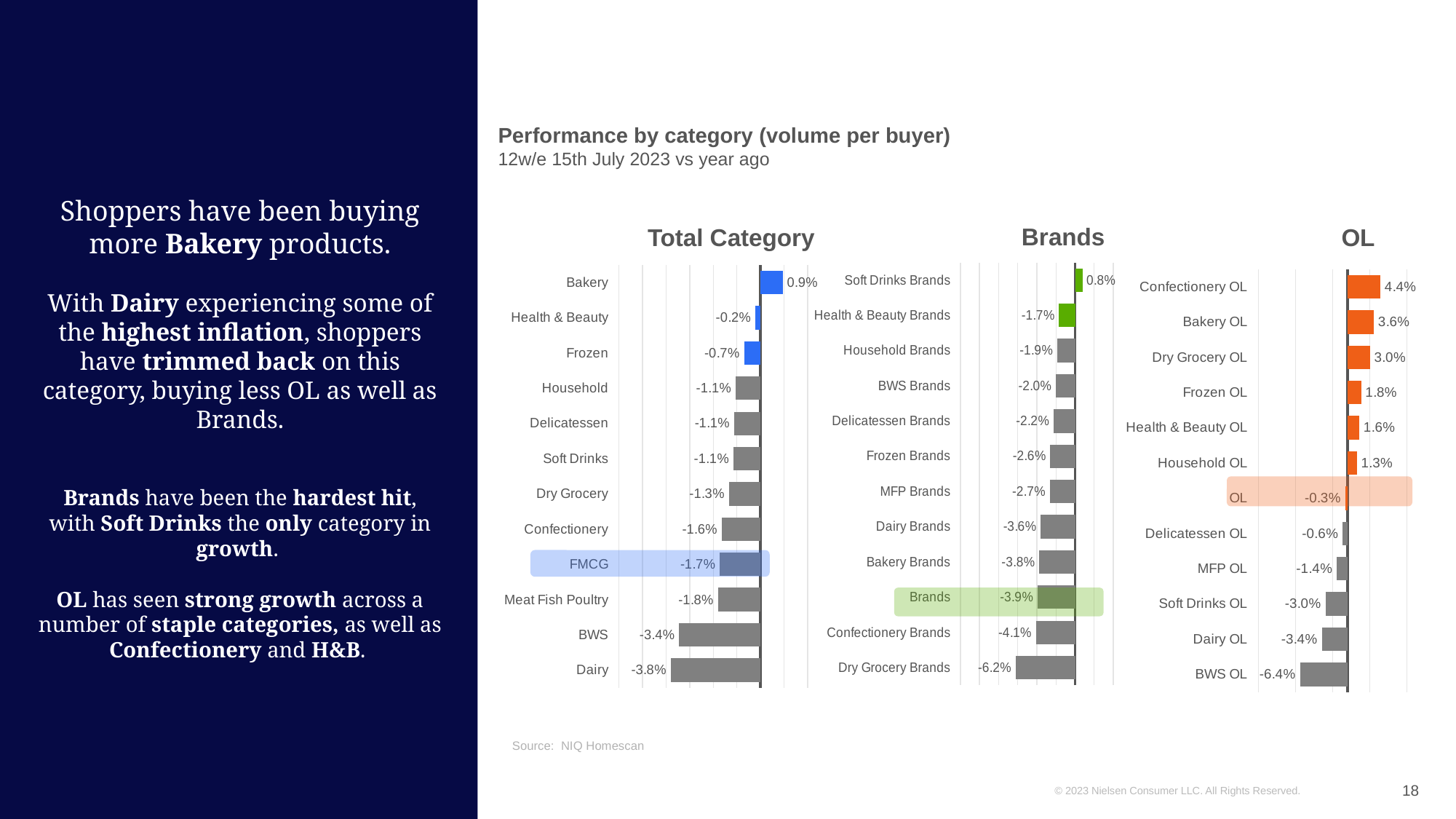
In the Total Category chart, what is the value for Bakery? 0.9% In the Total Category chart, what is the difference between BWS and Dairy? 0.4% In the OL chart, which category has the lowest value? BWS OL In the Total Category chart, which category has the lowest value? Dairy In the Brands chart, which category has the highest value? Soft Drinks Brands In the Total Category chart, what is the value for FMCG? -1.7% In the OL chart, which is larger, Bakery OL or Dry Grocery OL? Bakery OL In the Brands chart, what is the value for Dry Grocery Brands? -6.2% What type of chart is the OL chart? Bar chart How many categories are shown in the Total Category chart? 12 In the OL chart, what is the value for Confectionery OL? 4.4% In the Brands chart, what is the difference between Soft Drinks Brands and Dry Grocery Brands? 7.0%